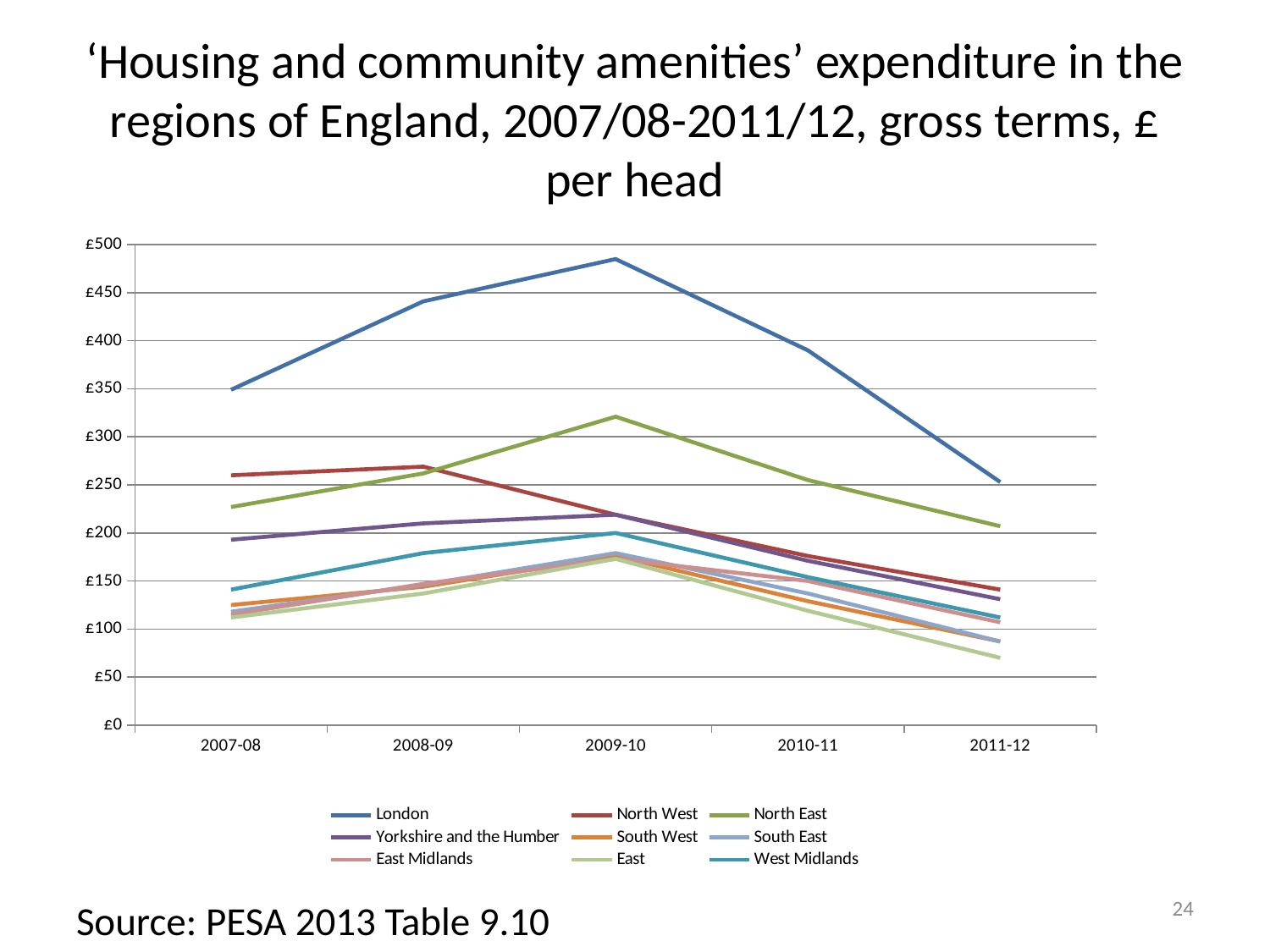
Which region has the lowest expenditure per head in 2011-12? East In 2011-12, which is larger: the value for North East or the value for North West? North East Is the value for London in 2011-12 greater or less than £300? less Does the London line rise or fall between 2009-10 and 2011-12? fall Is the value for London in 2009-10 greater or less than £450? greater What is the source cited below the chart? PESA 2013 Table 9.10 How many regions are listed in the chart's legend? 9 What kind of chart is shown on the slide? line chart Is the value for East in 2011-12 greater or less than £100? less How many financial years are shown along the x axis? 5 Which region has the highest expenditure per head in 2009-10? London